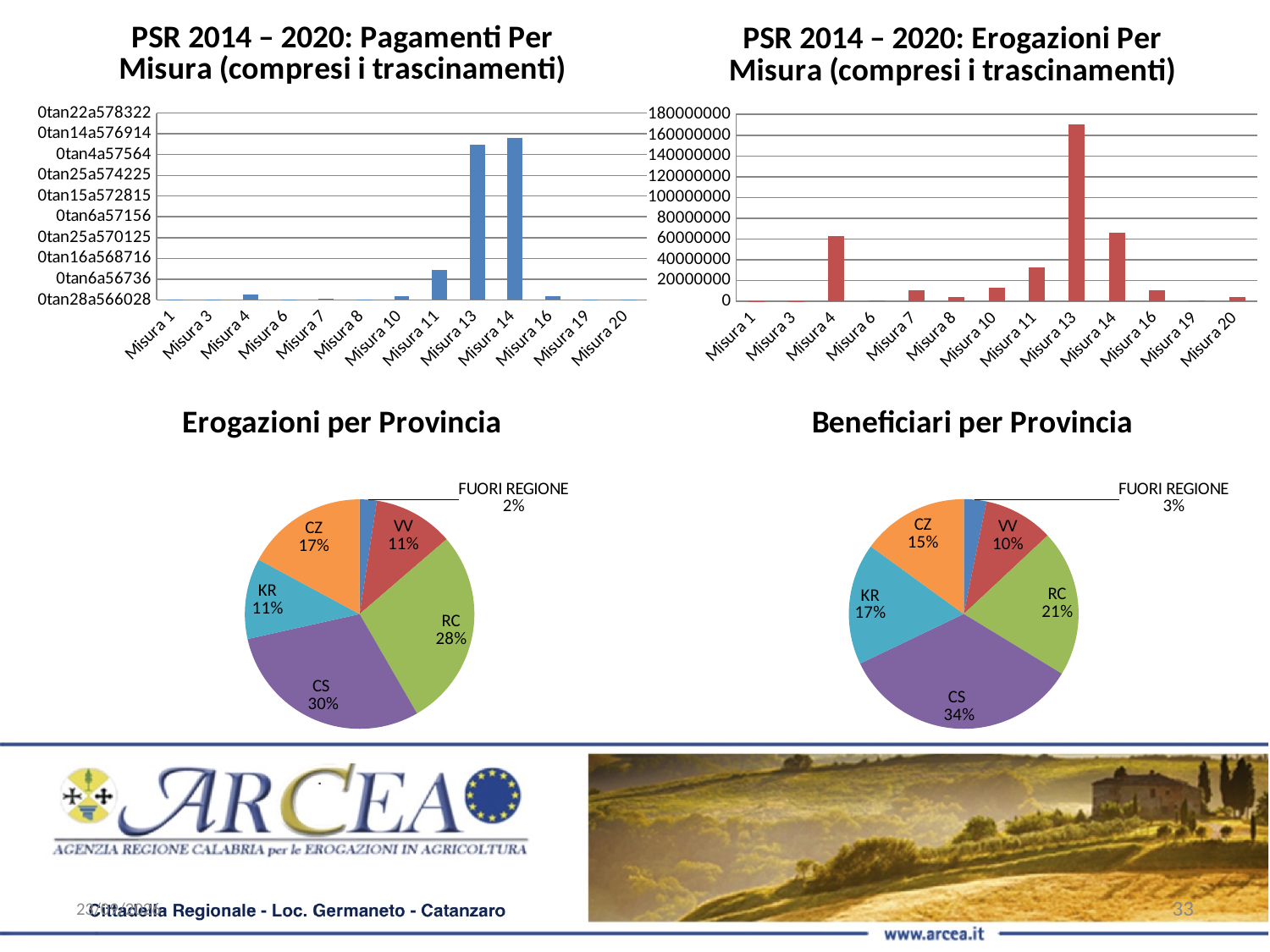
How many Misura categories are shown on the x axis of the 'PSR 2014 – 2020: Erogazioni Per Misura' chart? 13 In the 'PSR 2014 – 2020: Erogazioni Per Misura' chart, is the value for Misura 11 greater or less than 20000000? greater In the 'PSR 2014 – 2020: Erogazioni Per Misura' chart, which Misura has the highest value? Misura 13 In the 'Erogazioni per Provincia' pie chart, what share does CS have? 30% How many slices does the 'Beneficiari per Provincia' pie chart have? 6 In the 'Beneficiari per Provincia' pie chart, which slice is the smallest? FUORI REGIONE In the 'Erogazioni per Provincia' pie chart, which province has the largest share? CS In the 'Beneficiari per Provincia' pie chart, what share does KR have? 17% What kind of chart is 'PSR 2014 – 2020: Pagamenti Per Misura (compresi i trascinamenti)'? bar chart In the 'PSR 2014 – 2020: Erogazioni Per Misura' chart, is the value for Misura 13 greater or less than 160000000? greater In the 'Erogazioni per Provincia' pie chart, what is the difference between the shares of RC and VV? 17% In the 'Beneficiari per Provincia' pie chart, which is larger, the share of CZ or the share of RC? RC